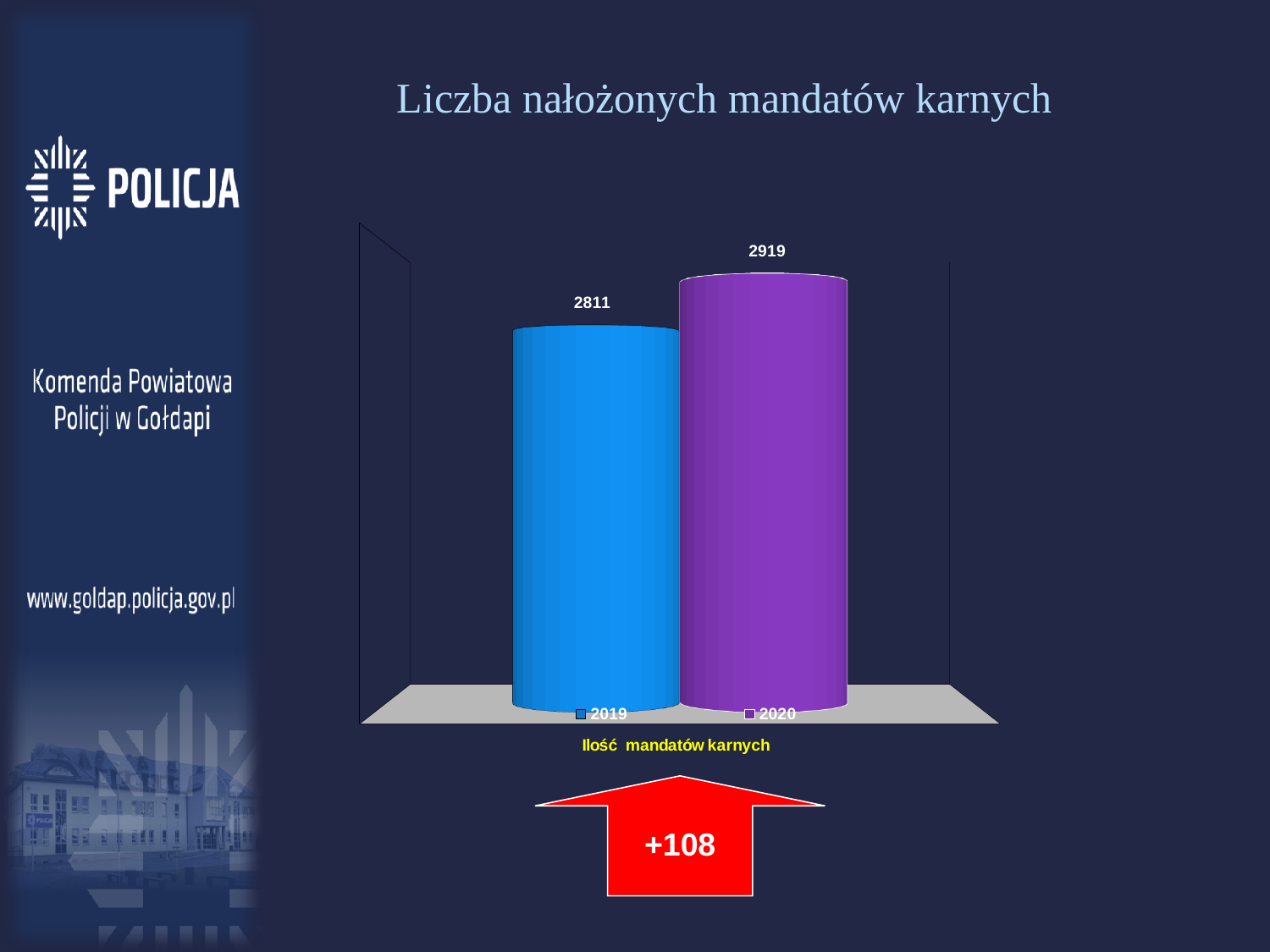
How many bars are shown in the chart? 2 What kind of chart is shown on the slide? Bar chart What is the value for 2019? 2811 What is the title of the chart? Liczba nałożonych mandatów karnych What colour is the bar for 2020? Purple What is the value for 2020? 2919 How many entries does the legend list? 2 Is the value for 2020 larger than the value for 2019? Yes Which year has the lower number of fines? 2019 What is the difference between the 2020 and 2019 values? 108 Do the values rise or fall from 2019 to 2020? Rise Which year has the higher number of fines? 2020